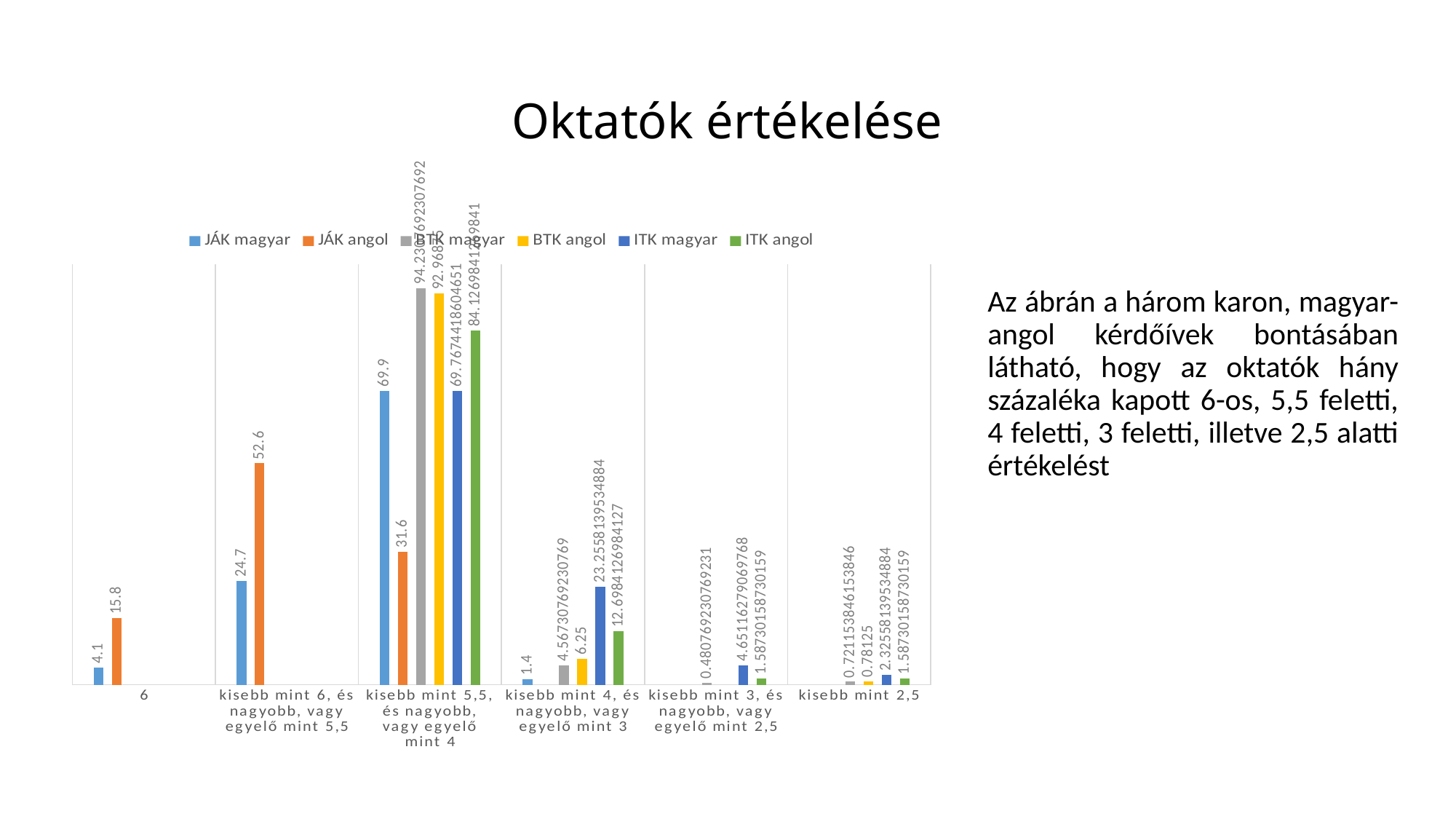
What is the value for BTK angol in the category "kisebb mint 4, és nagyobb, vagy egyelő mint 3"? 6.25 What is the value for BTK magyar in the category "kisebb mint 5,5, és nagyobb, vagy egyelő mint 4"? 94.2307692307692 Which series has the highest value in the category "kisebb mint 5,5, és nagyobb, vagy egyelő mint 4"? BTK magyar Which series has the lowest value in the category "kisebb mint 2,5"? BTK magyar What is the difference between JÁK angol and JÁK magyar in the category "kisebb mint 6, és nagyobb, vagy egyelő mint 5,5"? 27.9 What is the value for JÁK angol in the category "6"? 15.8 What is the value for JÁK magyar in the category "kisebb mint 6, és nagyobb, vagy egyelő mint 5,5"? 24.7 How many series does the legend list? 6 How many categories are shown on the x axis? 6 Which is larger in the category "kisebb mint 4, és nagyobb, vagy egyelő mint 3": ITK magyar or ITK angol? ITK magyar What is the title of the chart? Oktatók értékelése What type of chart is shown on the slide? bar chart